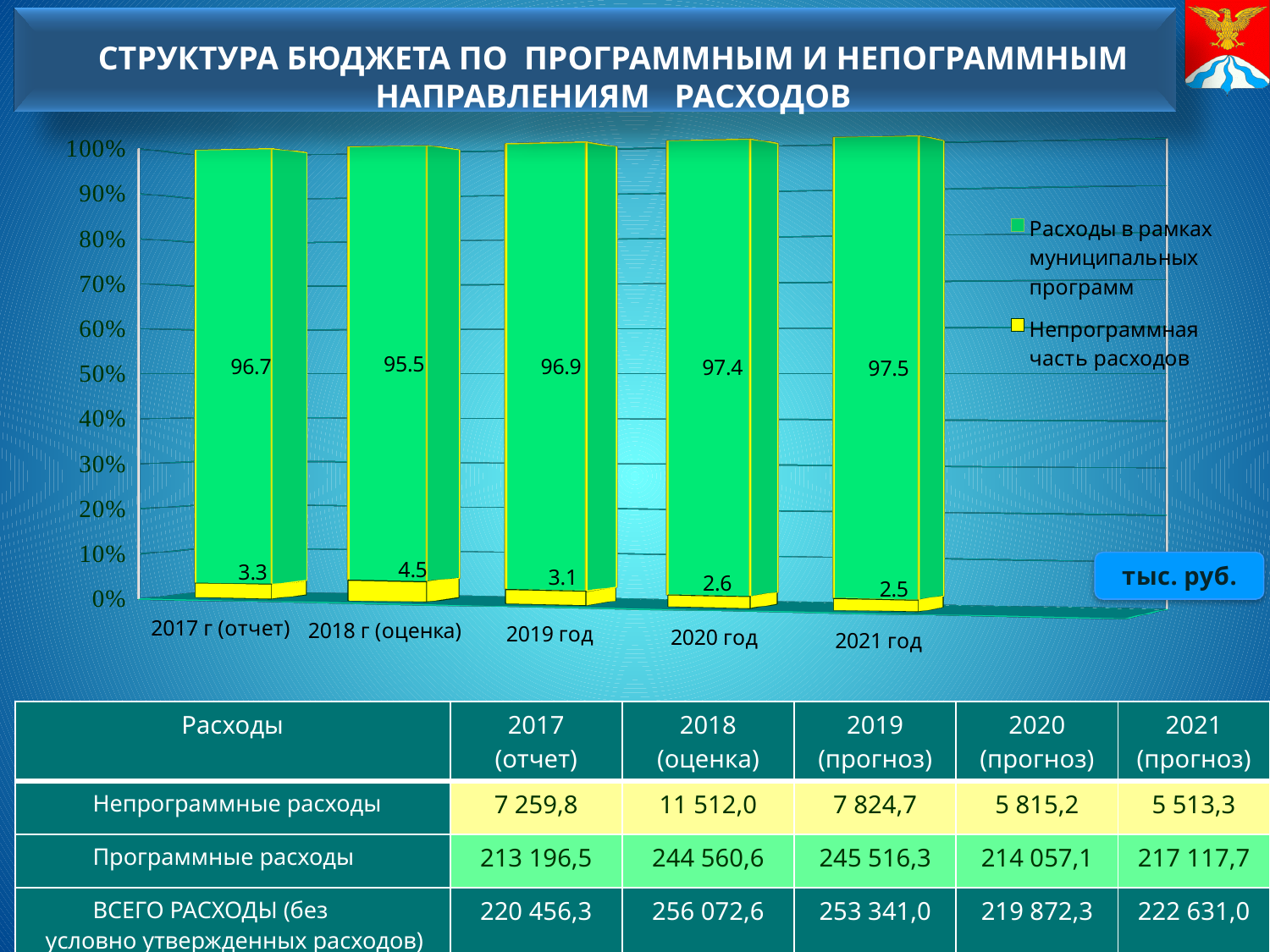
In which year is the yellow series (Непрограммная часть расходов) lowest? 2021 год In which year is the yellow series (Непрограммная часть расходов) highest? 2018 г (оценка) What is the value of the yellow series (Непрограммная часть расходов) for 2018 г (оценка)? 4.5 How many years (categories) are shown on the x axis of the chart? 5 What is the value of the green series (Расходы в рамках муниципальных программ) for 2019 год? 96.9 Which colour represents Непрограммная часть расходов in the chart? Yellow What is the value of the yellow series (Непрограммная часть расходов) for 2021 год? 2.5 What is the difference between the yellow series values for 2018 г (оценка) and 2017 г (отчет)? 1.2 How many series does the chart legend list? 2 Which is larger: the green series value for 2020 год or for 2018 г (оценка)? 2020 год What kind of chart is shown on the slide? Stacked bar chart In which year is the green series (Расходы в рамках муниципальных программ) highest? 2021 год